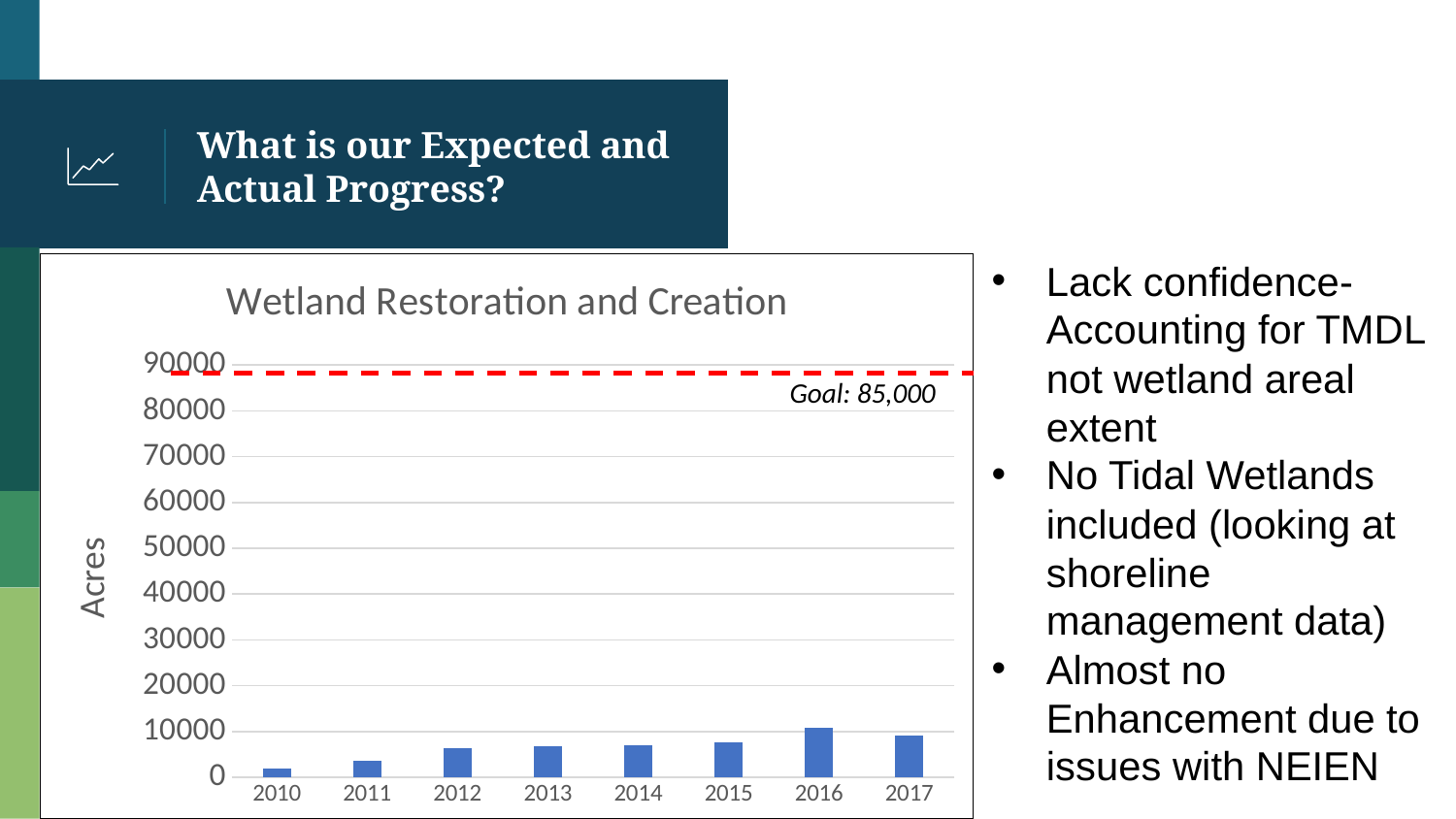
Is the value for 2010 greater or less than 10000? less What kind of chart is shown on the slide? bar chart Do the bar values generally rise or fall from 2010 to 2016? rise Is the value for 2016 greater or less than 10000? greater How many years are shown on the x axis of the chart? 8 Is the value for 2017 greater or less than 10000? less What is the title of the chart? Wetland Restoration and Creation Which year has a larger value, 2011 or 2015? 2015 Which year has a larger value, 2016 or 2017? 2016 Which year has the highest bar in the chart? 2016 What is the label on the vertical axis of the chart? Acres Which year has the lowest bar in the chart? 2010